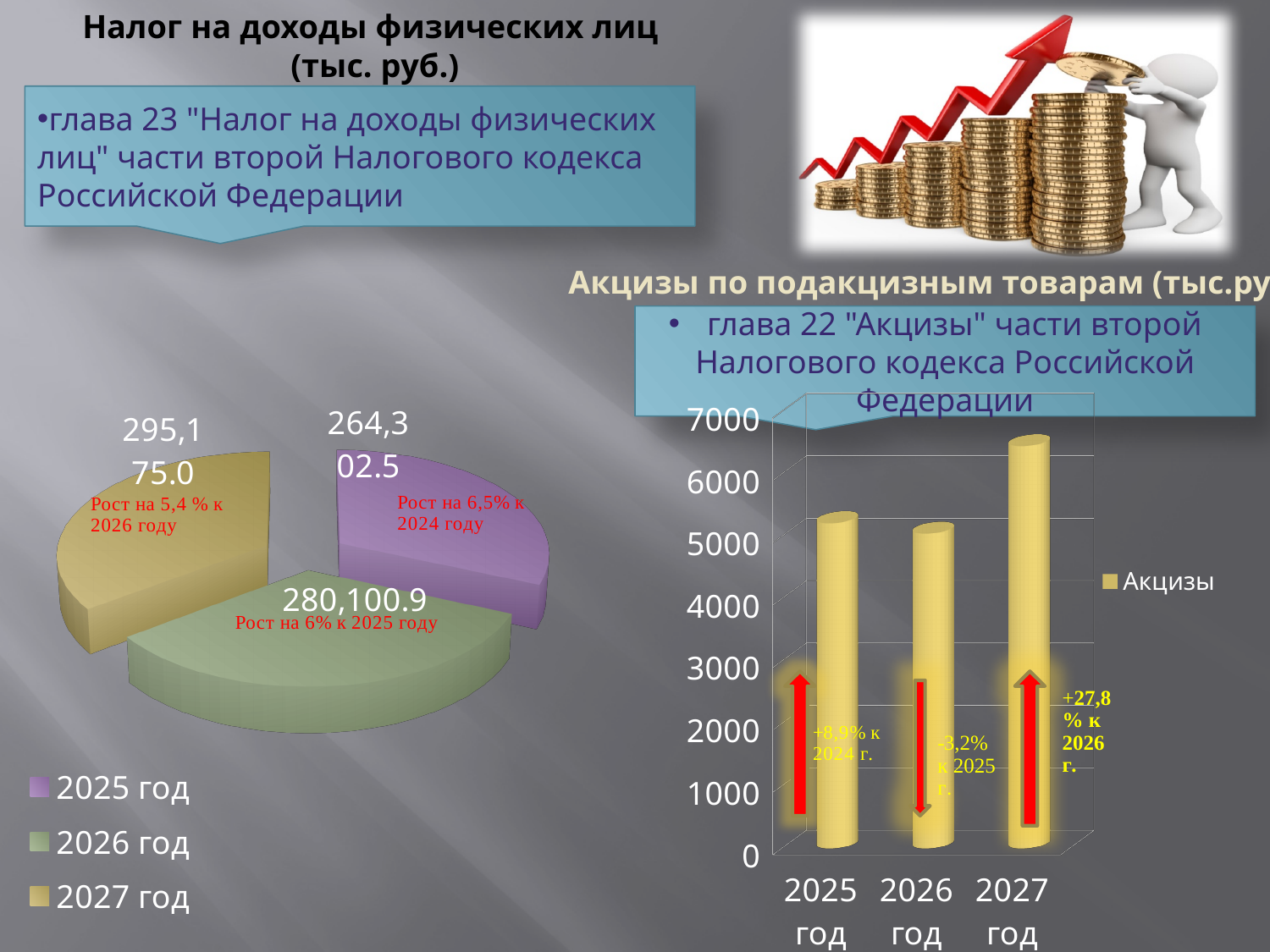
On the Акцизы bar chart on the right, is the value for 2027 год greater or less than 6000? greater On the Акцизы bar chart on the right, is the value for 2026 год greater or less than 6000? less How many bars are there on the Акцизы bar chart on the right? 3 On the Акцизы bar chart on the right, which year has the highest bar? 2027 год How many series does the legend of the bar chart on the right list? 1 What kind of chart is the Акцизы chart on the right of the slide? bar chart On the Акцизы bar chart on the right, is the value for 2025 год greater or less than 5000? greater What kind of chart is the chart on the left of the slide? pie chart On the pie chart on the left, what value is shown for 2026 год? 280,100.9 How many slices does the pie chart on the left have? 3 How many entries does the legend of the pie chart on the left list? 3 On the pie chart on the left, which colour represents 2027 год? gold